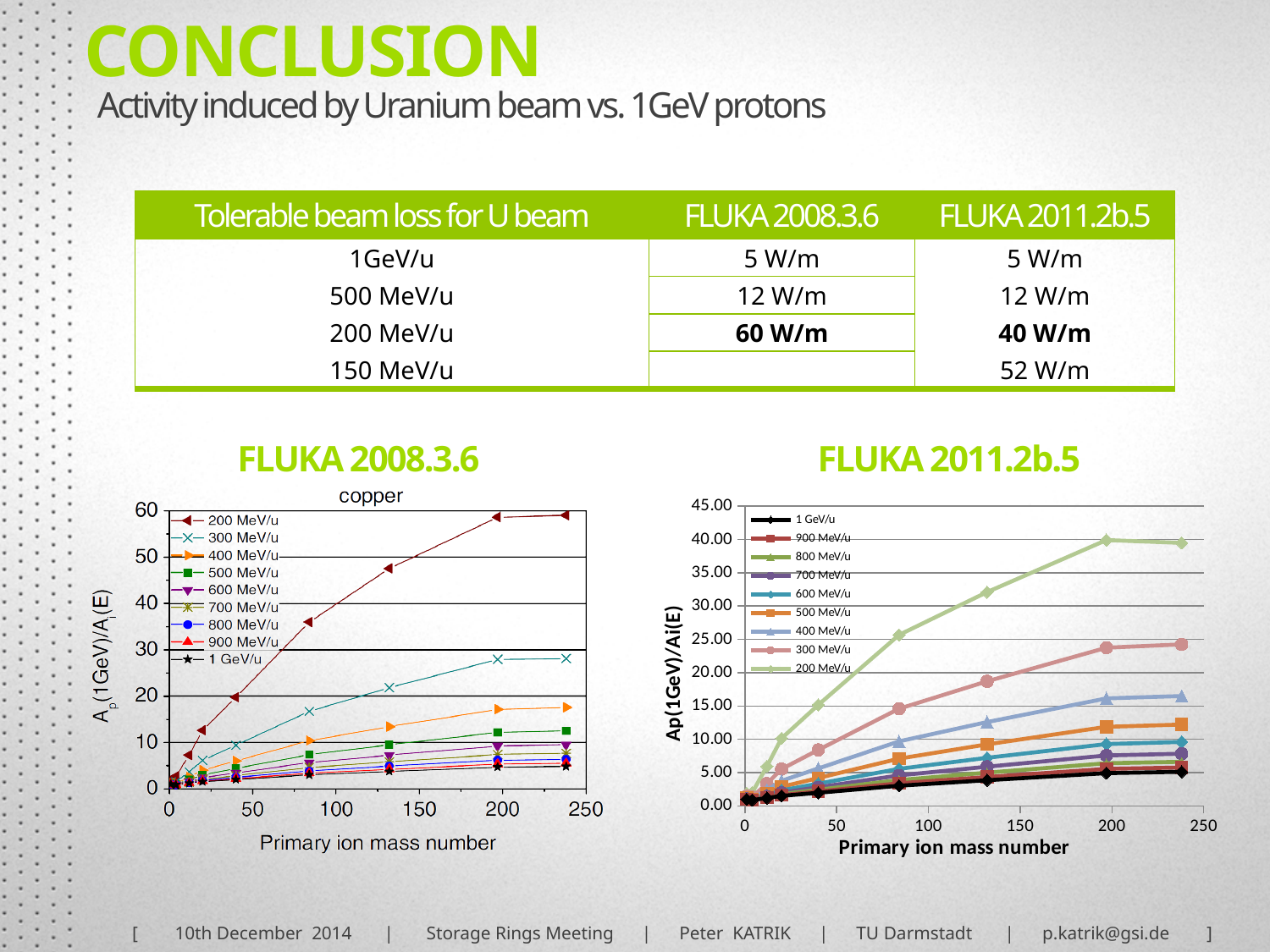
In the FLUKA 2008.3.6 chart, which series reaches the highest values? 200 MeV/u What kind of chart is the FLUKA 2011.2b.5 chart on the right? line chart What is the x-axis title of the FLUKA 2011.2b.5 chart? Primary ion mass number What kind of chart is the FLUKA 2008.3.6 chart on the left? line chart How many series does the legend of the FLUKA 2008.3.6 chart list? 9 In the FLUKA 2011.2b.5 chart, at the highest mass number, which series has the larger value: 300 MeV/u or 400 MeV/u? 300 MeV/u In the FLUKA 2011.2b.5 chart, which series has the lowest values? 1 GeV/u In the FLUKA 2011.2b.5 chart, is the value of the 200 MeV/u series at the highest mass number greater or less than 35.00? greater In the FLUKA 2008.3.6 chart, do the values of the 200 MeV/u series rise or fall as the primary ion mass number increases? rise How many series does the legend of the FLUKA 2011.2b.5 chart list? 9 In the FLUKA 2008.3.6 chart, is the value of the 200 MeV/u series at the highest mass number greater or less than 50? greater In the FLUKA 2011.2b.5 chart, is the value of the 1 GeV/u series at the highest mass number greater or less than 10.00? less